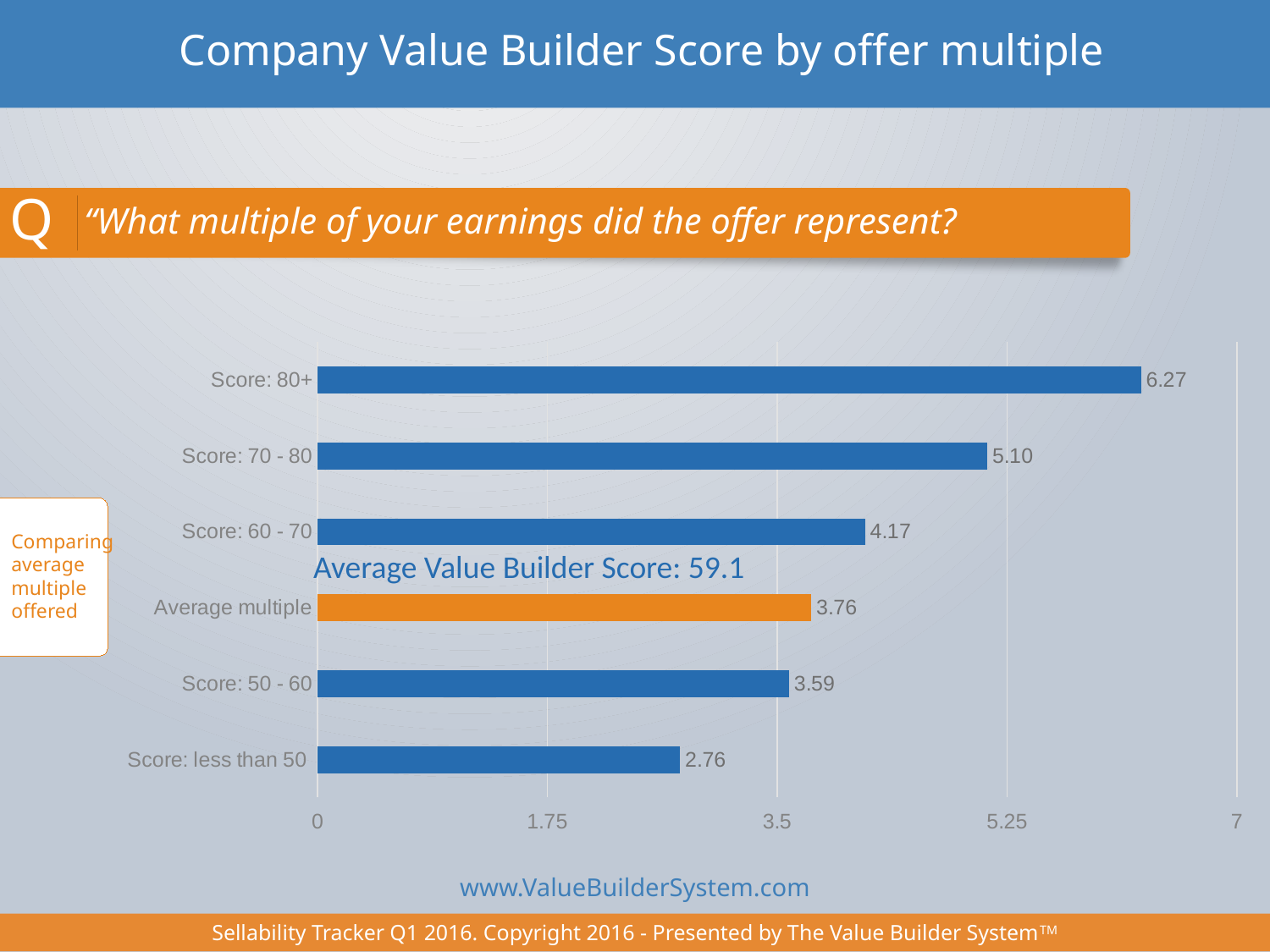
What is the value for Score: 70 - 80? 5.10 Which category has the lowest value? Score: less than 50 How many bars are shown in the chart? 6 What is the value of the Average multiple bar? 3.76 What is the difference between the values for Score: 60 - 70 and Score: 50 - 60? 0.58 What is the value for Score: 80+? 6.27 What is the value for Score: less than 50? 2.76 What Average Value Builder Score is stated on the chart? 59.1 What is the difference between the values for Score: 80+ and Score: less than 50? 3.51 What kind of chart is shown on the slide? Bar chart Which category has the highest value? Score: 80+ Which is larger, the value for Score: 70 - 80 or Score: 60 - 70? Score: 70 - 80